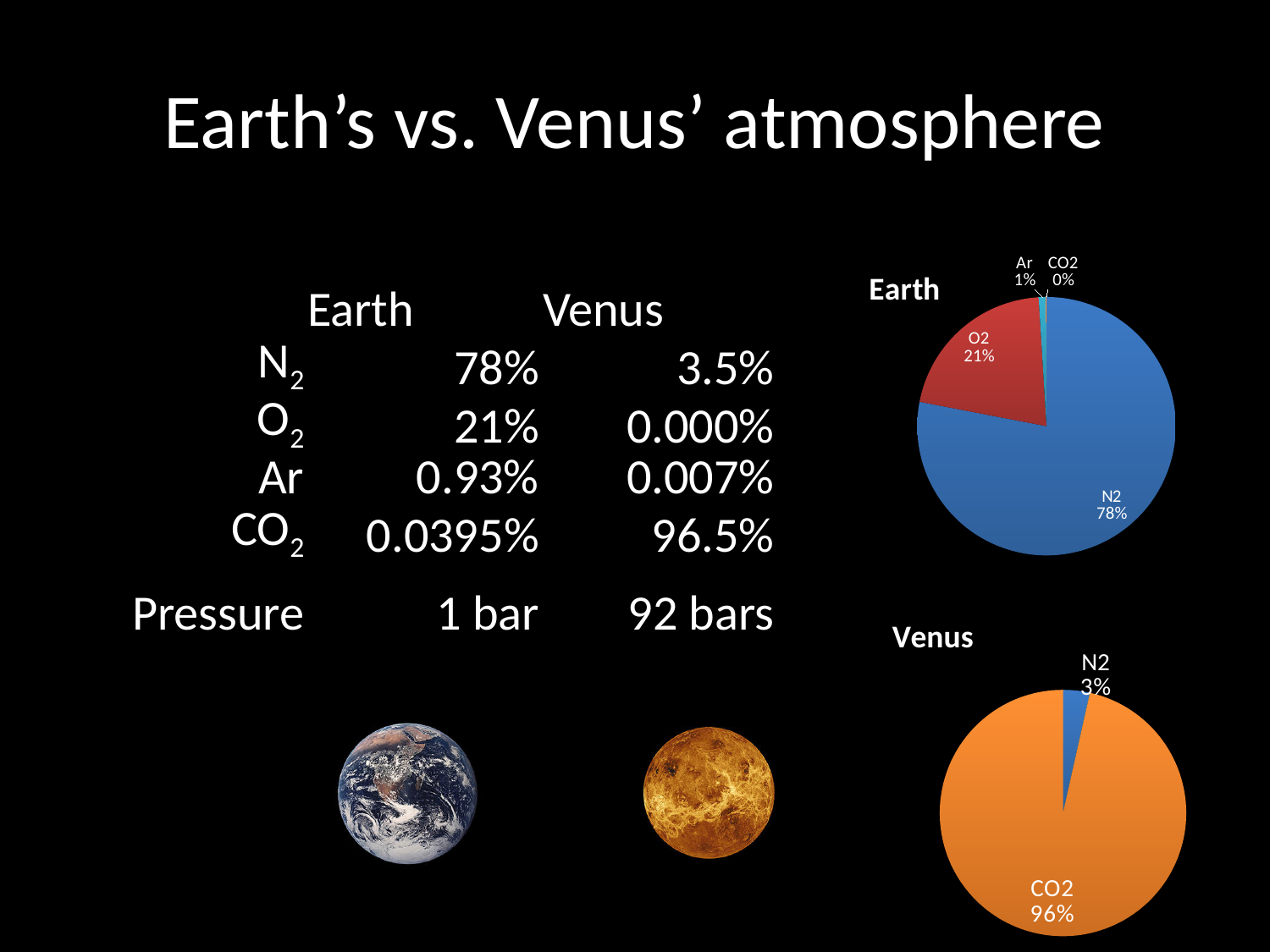
How many slices are labelled in the Earth pie chart? 4 In the Venus pie chart, which gas has the largest slice? CO2 In the Earth pie chart, which gas has the smallest slice? CO2 In the Earth pie chart, what share does Ar have? 1% In the Venus pie chart, what is the difference between the CO2 share and the N2 share? 93% In the Venus pie chart, what share does N2 have? 3% In the Earth pie chart, what is the difference between the N2 share and the O2 share? 57% What type of chart is the Venus chart? Pie chart In the Earth pie chart, what share does O2 have? 21% In the Earth pie chart, which gas has the largest slice? N2